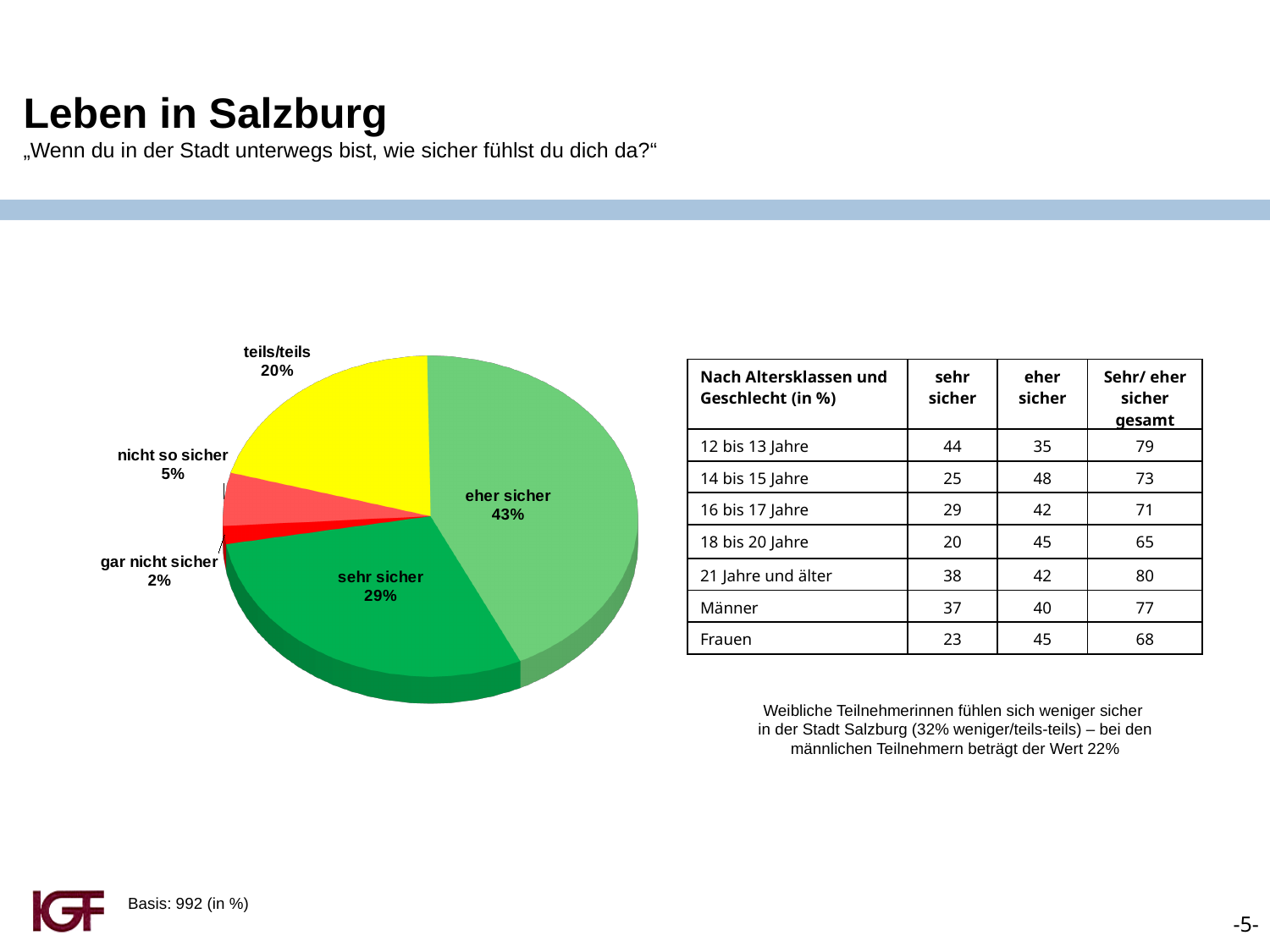
What is the value for "teils/teils" in the pie chart? 20% Which category has the largest slice in the pie chart? eher sicher What type of chart is shown on the slide? pie chart How many slices does the pie chart have? 5 What is the value for "nicht so sicher" in the pie chart? 5% What is the value for "gar nicht sicher" in the pie chart? 2% What colour is the "teils/teils" slice in the pie chart? yellow What share of the pie does "eher sicher" represent? 43% What is the value for "sehr sicher" in the pie chart? 29% Which is larger in the pie chart, "teils/teils" or "nicht so sicher"? teils/teils Which category has the smallest slice in the pie chart? gar nicht sicher What is the difference between the "eher sicher" and "sehr sicher" slices? 14%